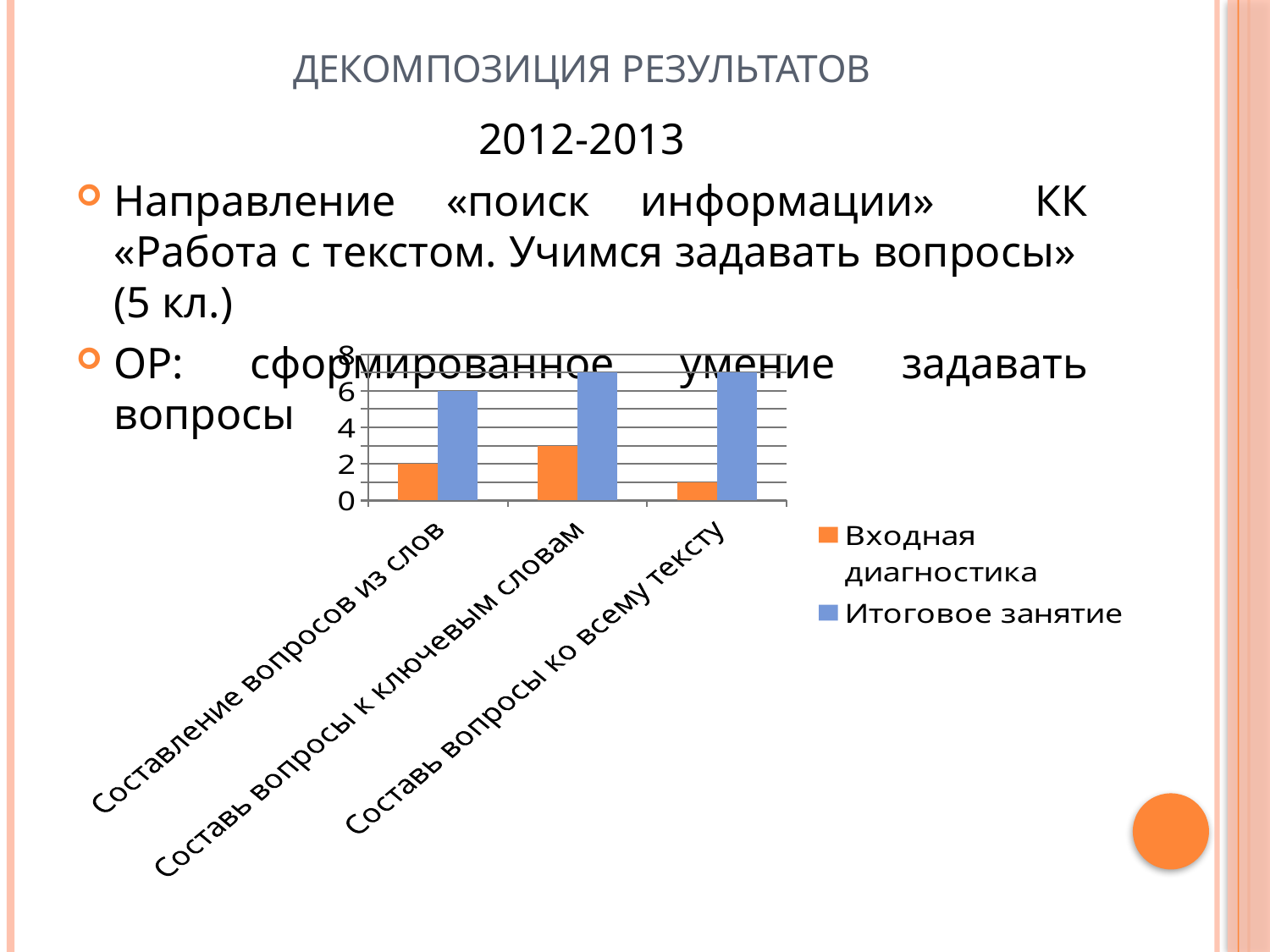
Which series is shown in orange in the chart? Входная диагностика Is the value of Входная диагностика for Составь вопросы ко всему тексту greater or less than 2? less How many categories are shown on the x axis of the chart? 3 For Составь вопросы ко всему тексту, which series has the larger value, Входная диагностика or Итоговое занятие? Итоговое занятие What is the value of Входная диагностика for Составление вопросов из слов? 2 Is the value of Входная диагностика for Составь вопросы к ключевым словам greater or less than 2? greater How many series does the chart legend list? 2 What kind of chart is shown on the slide? bar chart What is the value of Итоговое занятие for Составление вопросов из слов? 6 Is the value of Итоговое занятие for Составь вопросы ко всему тексту greater or less than 6? greater Which category has the highest value for Входная диагностика? Составь вопросы к ключевым словам Which category has the lowest value for Входная диагностика? Составь вопросы ко всему тексту